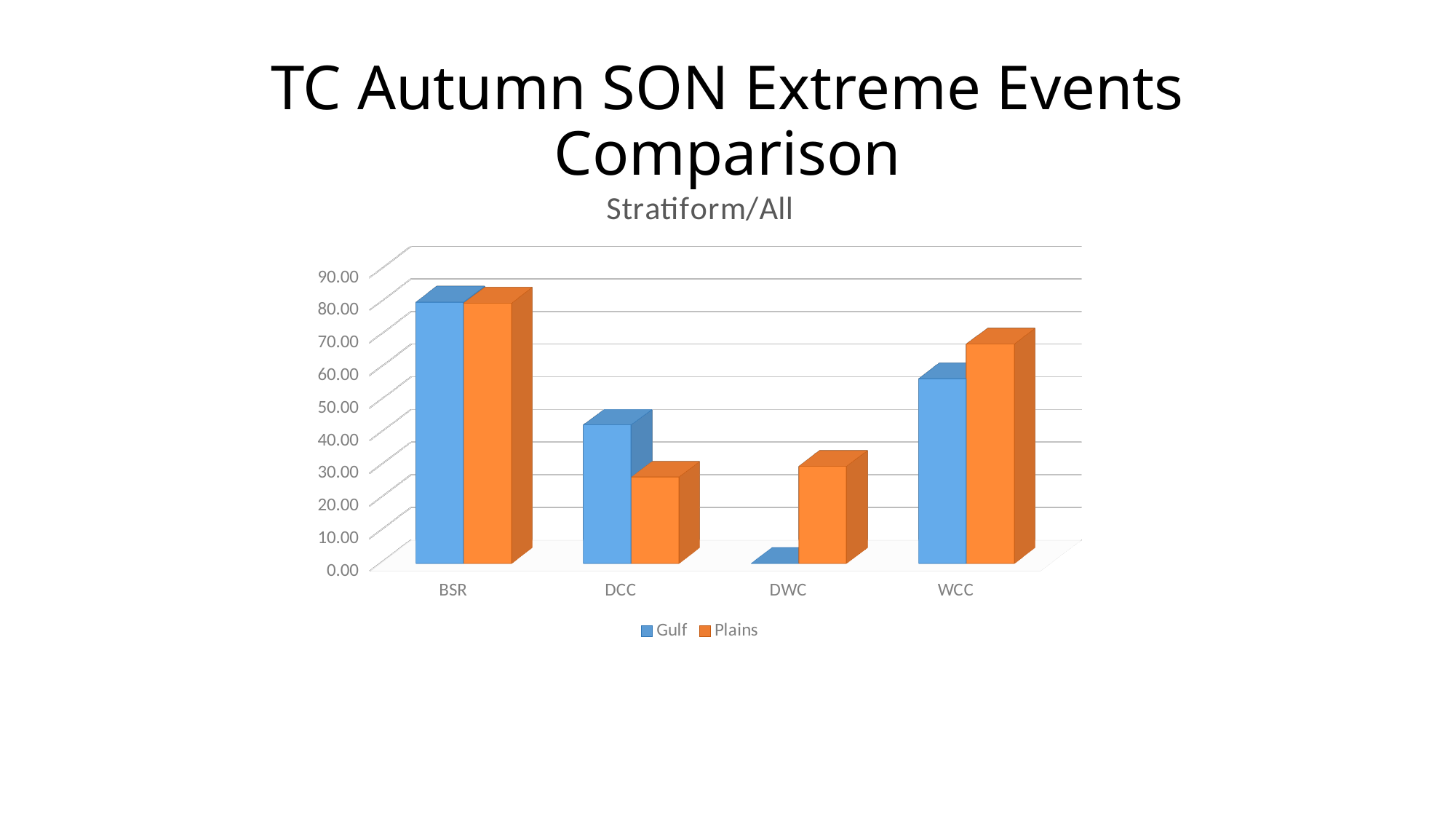
Which category has the lowest Gulf value? DWC Which category has the highest Gulf value? BSR For DCC, which series has the larger value, Gulf or Plains? Gulf For DWC, which series has the larger value, Gulf or Plains? Plains How many categories are shown on the x axis? 4 Which category has the highest Plains value? BSR What is the title of the chart? Stratiform/All What kind of chart is shown on the slide? bar chart How many series does the legend list? 2 Is the Plains value for WCC greater or less than 60.00? greater Is the Gulf value for DWC greater or less than 10.00? less Is the Plains value for DCC greater or less than 40.00? less